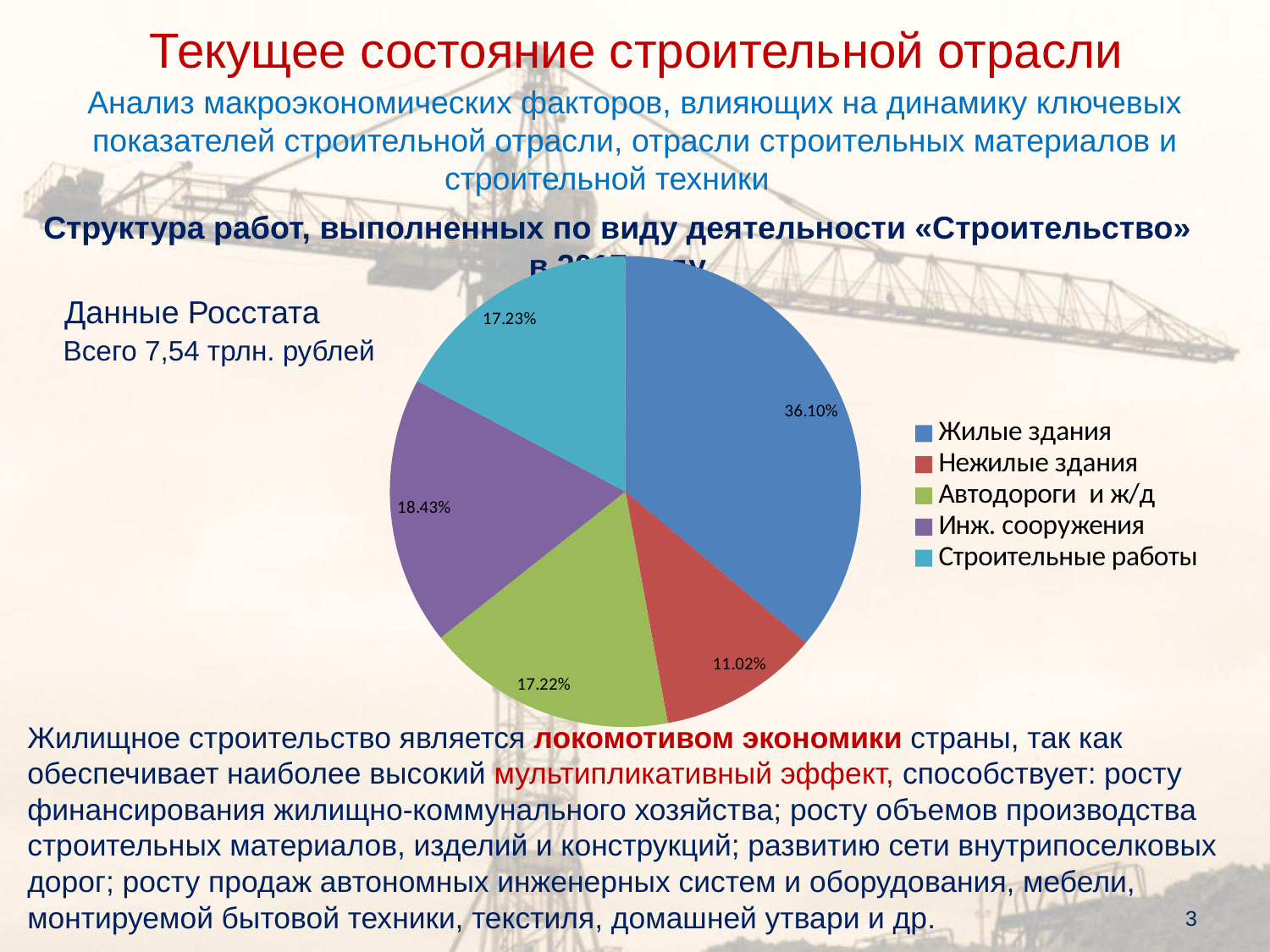
How many categories does the pie chart show? 5 What colour is the slice for «Жилые здания» in the pie chart? Blue What is the value shown for «Нежилые здания»? 11.02% What share of the pie does «Жилые здания» account for? 36.10% What is the value shown for «Инж. сооружения»? 18.43% What is the difference in percentage points between «Жилые здания» and «Нежилые здания»? 25.08 What type of chart is shown on the slide? Pie chart Which is larger: the share for «Инж. сооружения» or the share for «Нежилые здания»? Инж. сооружения Which category has the smallest slice of the pie? Нежилые здания What is the value shown for «Строительные работы»? 17.23% Which category has the largest slice of the pie? Жилые здания What is the value shown for «Автодороги и ж/д»? 17.22%